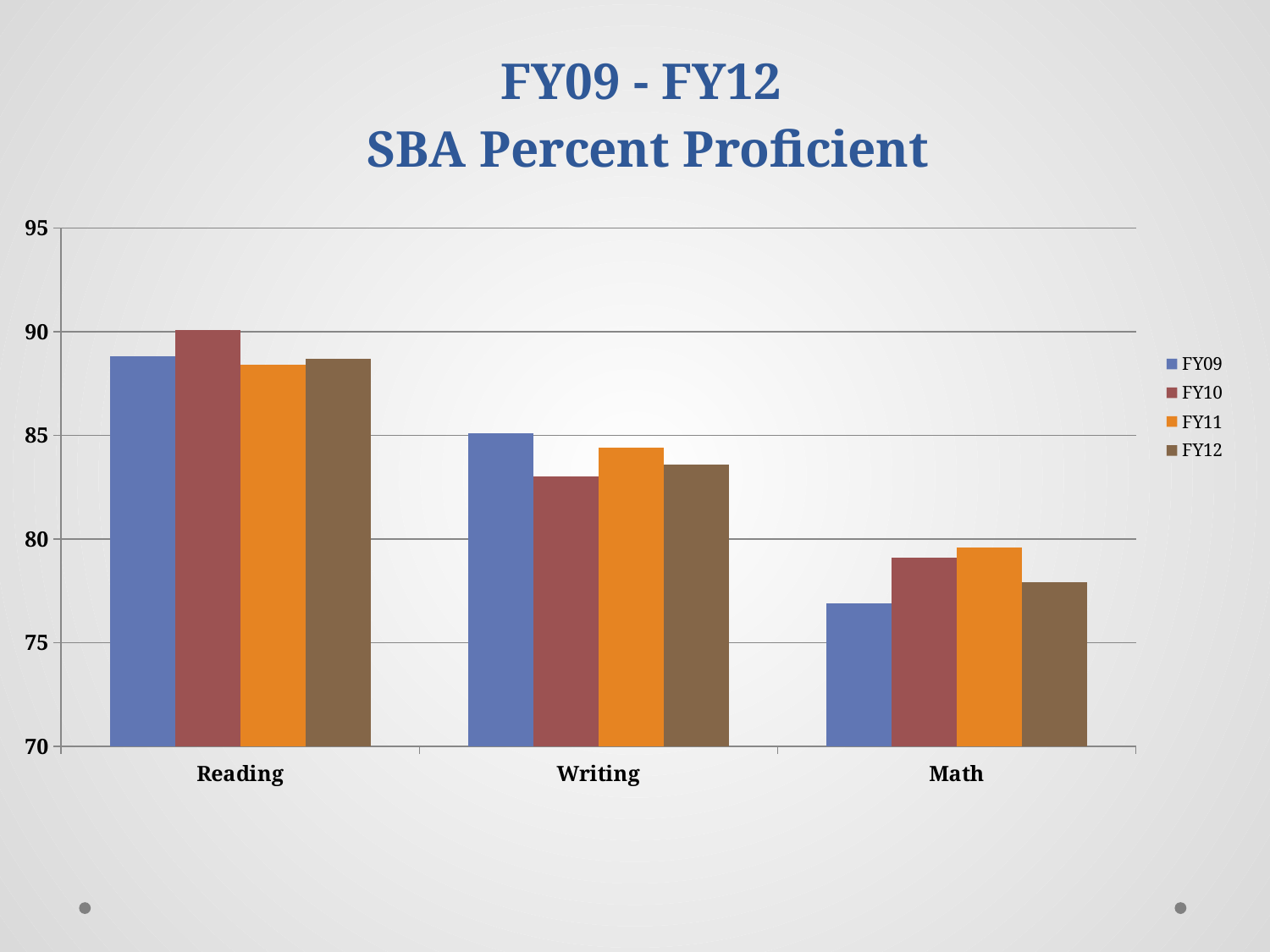
How many series does the legend list? 4 Which subject has the lowest FY12 bar? Math Do the FY09 values rise or fall moving from Reading to Writing to Math? fall Which is larger: the Writing value for FY09 or the Writing value for FY10? FY09 Which subject has the highest FY09 bar? Reading Is the value for Writing in FY10 greater or less than 85? less What kind of chart is shown on the slide? bar chart Is the value for Math in FY11 greater or less than 80? less Within the Math category, which fiscal year has the lowest bar? FY09 Within the Reading category, which fiscal year has the highest bar? FY10 How many subject categories are shown on the x axis? 3 Is the value for Math in FY09 greater or less than 75? greater